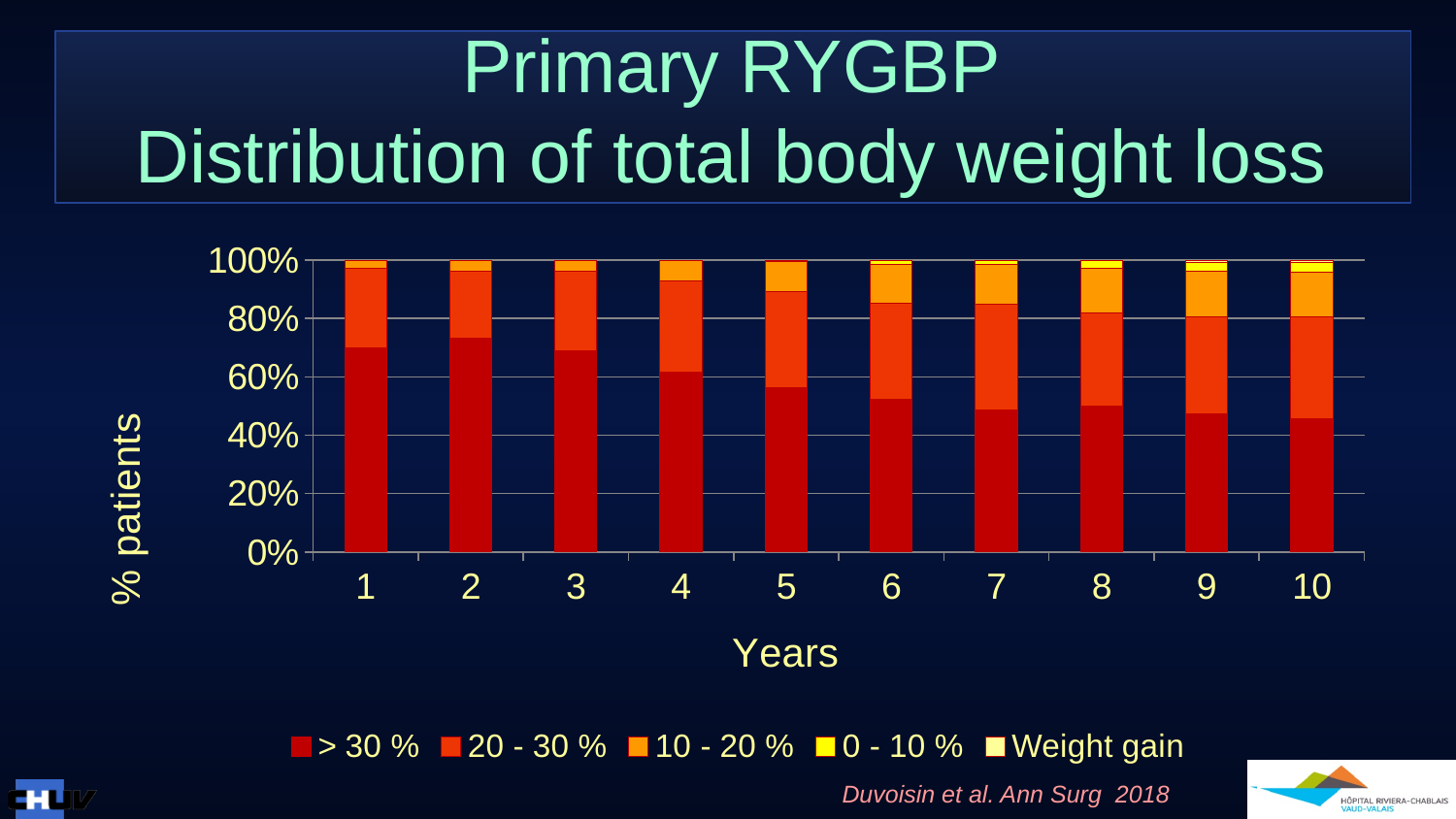
What is the total of the stacked bar for year 5? 100% How many years (categories) are shown on the x axis? 10 Is the share of patients with > 30 % weight loss at year 1 greater or less than 60%? greater Is the share of patients with > 30 % weight loss at year 7 greater or less than 60%? less Does the share of patients with > 30 % weight loss generally rise or fall from year 1 to year 10? Fall Is the share of patients with > 30 % weight loss at year 10 greater or less than 60%? less What kind of chart is shown on the slide? Stacked bar chart What is the label of the y axis? % patients Which is larger: the > 30 % segment at year 2 or at year 8? Year 2 What is the title of the chart? Primary RYGBP Distribution of total body weight loss How many series does the legend list? 5